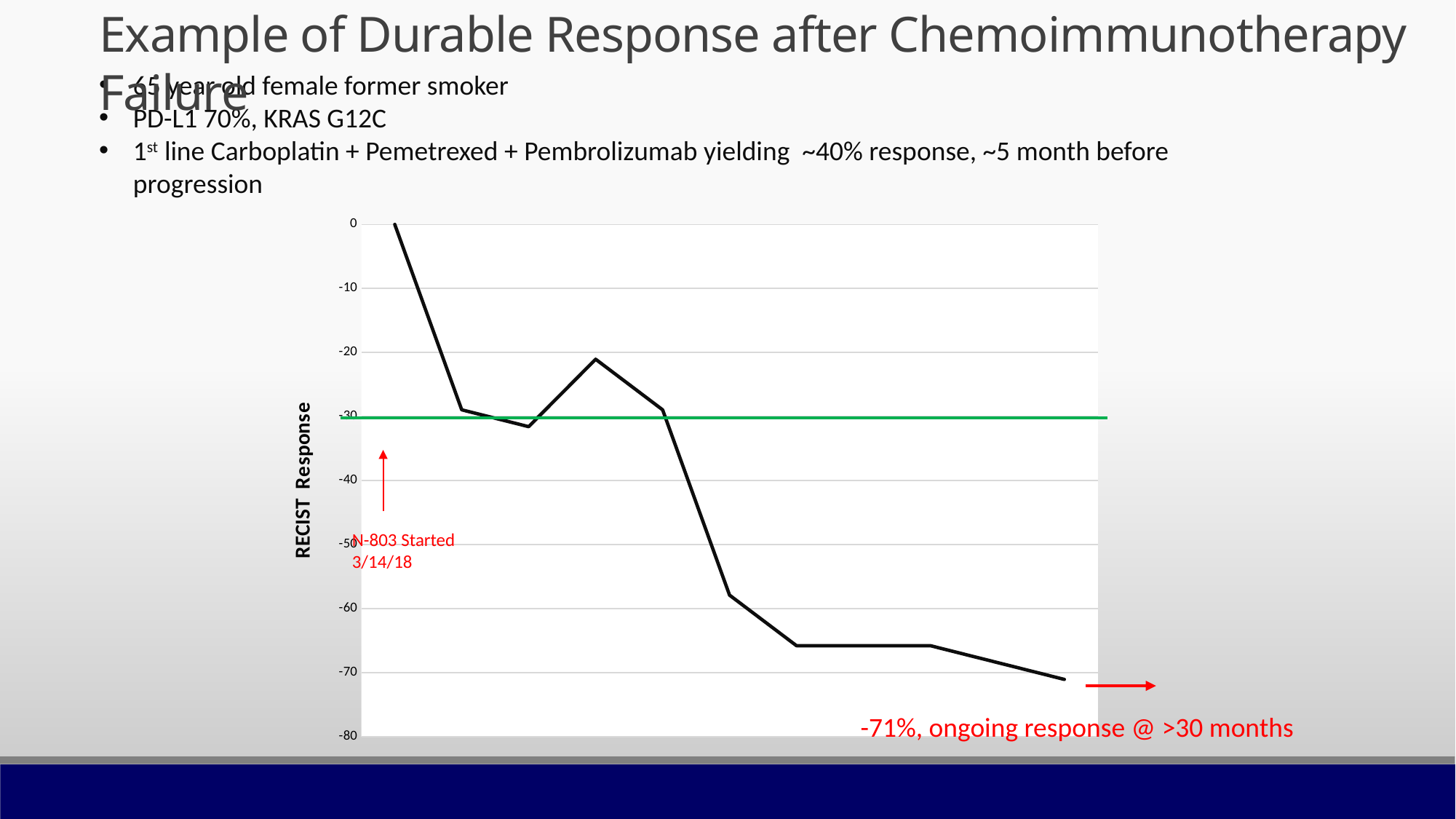
What is the difference between the first value (0) and the final annotated value (-71%)? 71 What is the RECIST response value at the first point of the line? 0 What is the label on the y axis of the chart? RECIST Response How many data points are plotted on the line? 11 Overall, does the line rise or fall from left to right? fall Is the value at the sixth point of the line (the first point after the steep drop) greater or less than -50? less What is the final RECIST response value reached by the line, as annotated on the chart? -71% At what y-axis value is the horizontal green reference line drawn? -30 Is the value at the local peak in the middle of the line (the fourth point) greater or less than -30? greater What kind of chart is shown on the slide? line chart Which point on the line has the highest RECIST response value, the first or the last? the first Which point on the line has the lowest RECIST response value, the first or the last? the last